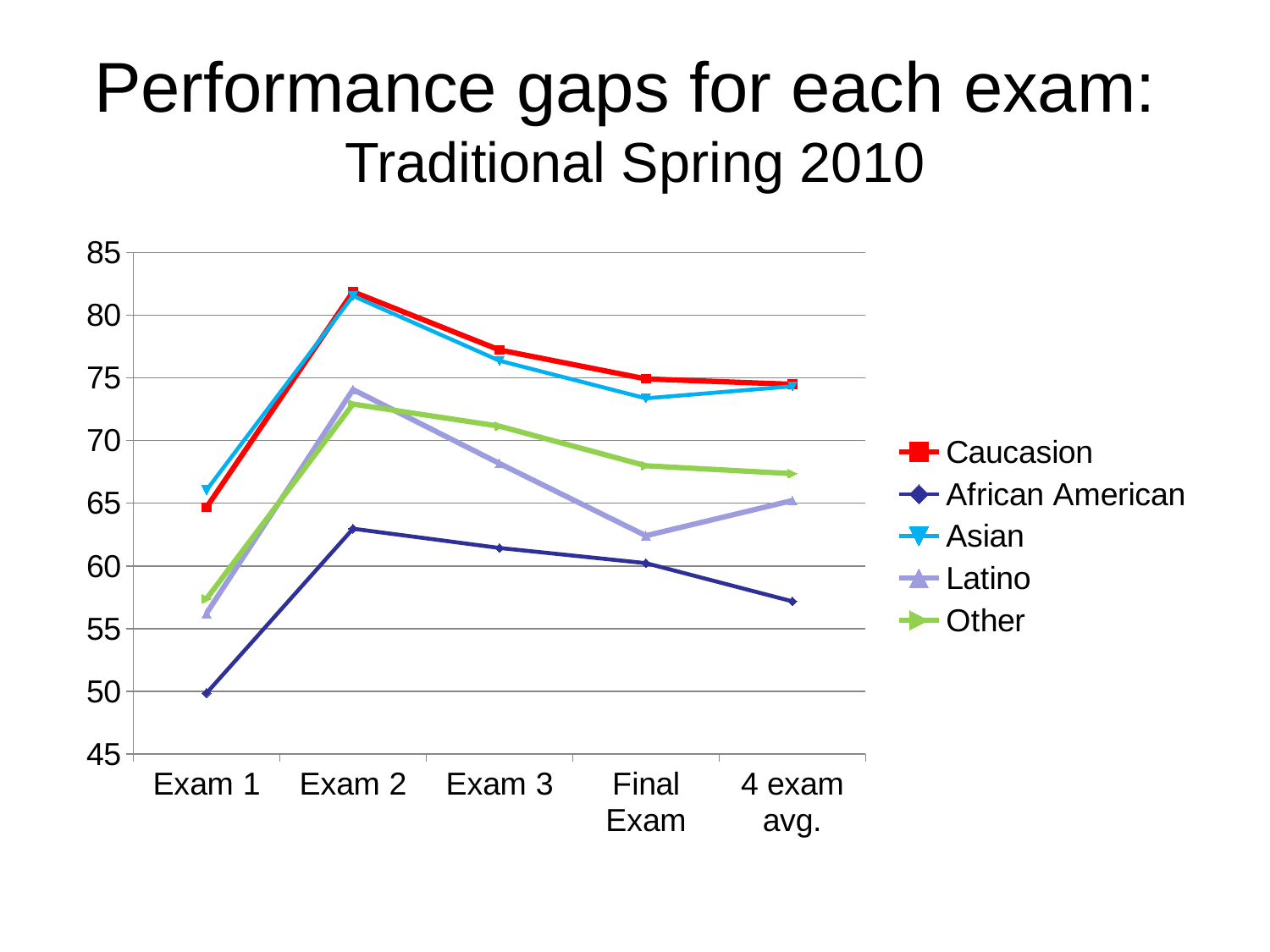
Is the value for Other at 4 exam avg. greater or less than 70? less At Final Exam, which is larger: Other or Latino? Other Is the value for African American at Exam 1 greater or less than 55? less Does the African American series rise or fall from Exam 2 to 4 exam avg.? fall How many categories are shown on the x axis? 5 Which series is lowest across all five categories? African American Is the value for Caucasion at Exam 2 greater or less than 80? greater Which series has the lowest value at Exam 1? African American What kind of chart is shown on the slide? line chart How many series does the legend list? 5 For which category does the Asian series reach its highest value? Exam 2